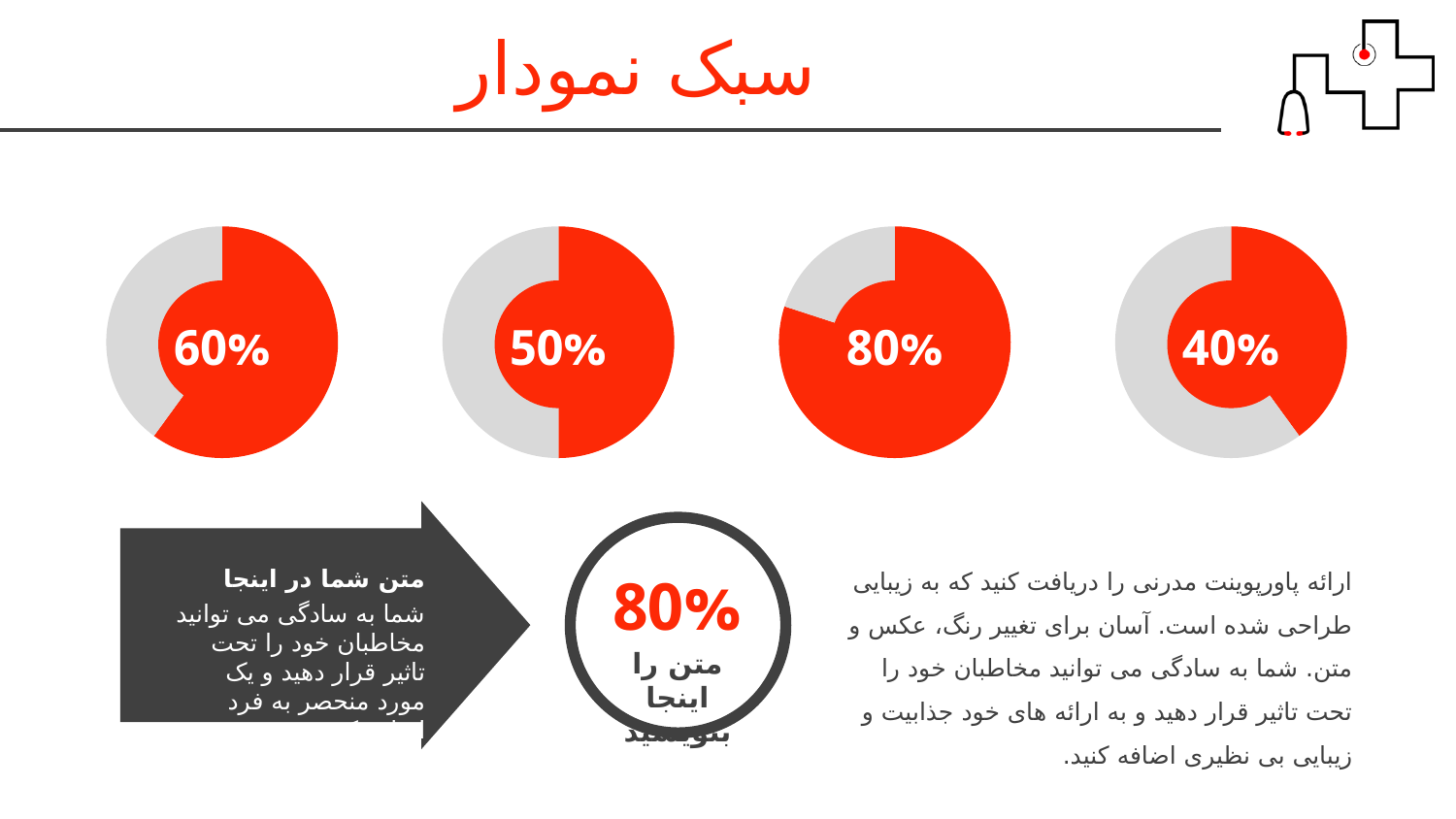
What is the difference between the percentage in the leftmost donut chart and the percentage in the second donut chart from the left? 10% How many donut charts are shown in the row across the slide? 4 What is the difference between the percentage in the third donut chart and the percentage in the rightmost donut chart? 40% Which is larger, the percentage in the leftmost donut chart or the percentage in the second donut chart from the left? The leftmost (60%) What kind of chart is used for the four percentage figures on the slide? Donut chart Which of the four donut charts shows the highest percentage? The third from the left (80%) What percentage is shown in the second donut chart from the left? 50% Which of the four donut charts shows the lowest percentage? The rightmost (40%) What percentage is shown in the leftmost donut chart? 60% What percentage is shown in the rightmost donut chart? 40% What colour is used for the filled (highlighted) portion of each donut chart? Red What percentage is shown in the third donut chart from the left? 80%